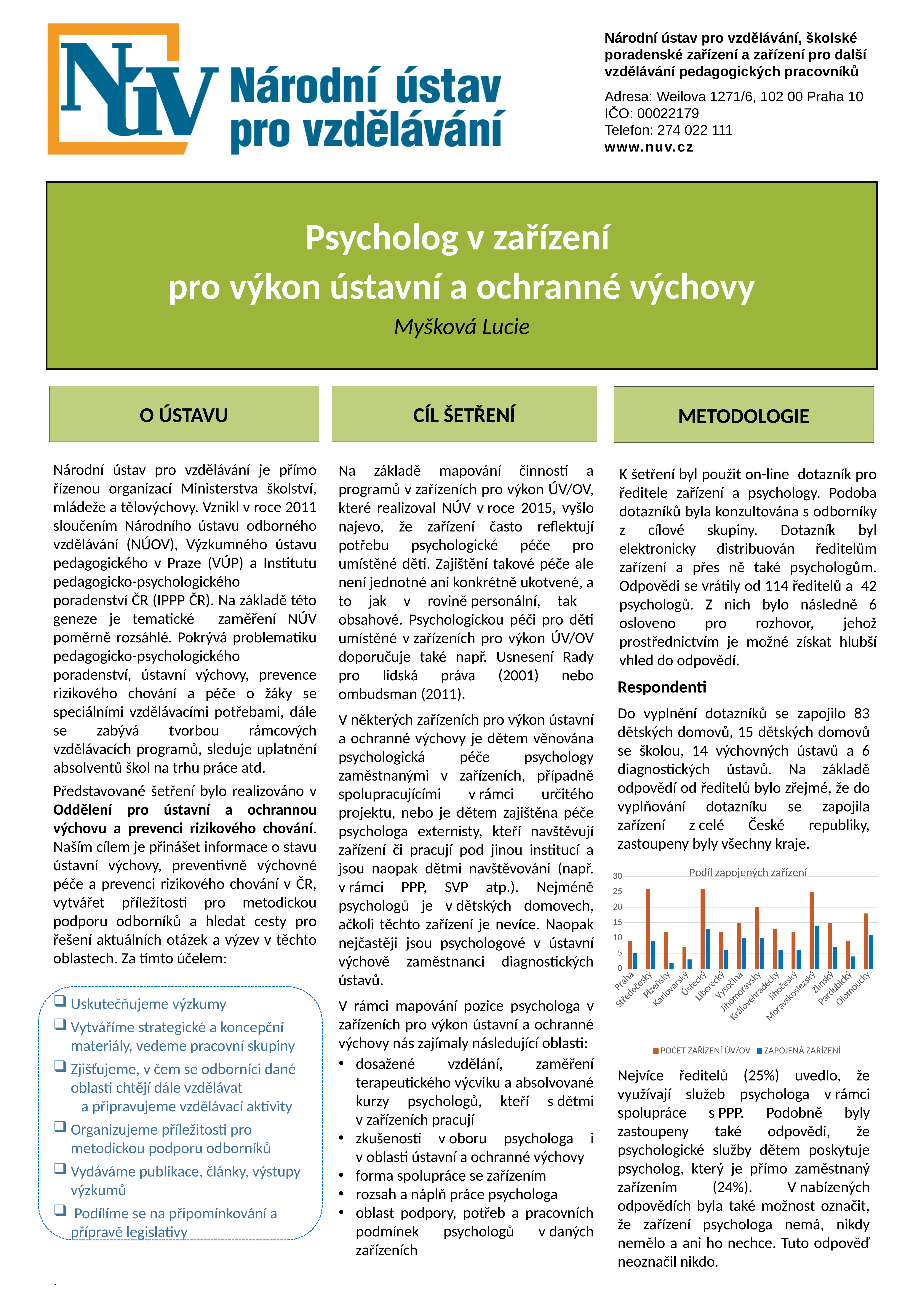
Is the value of POČET ZAŘÍZENÍ ÚV/OV for Středočeský greater or less than 20? greater What is the title of the chart on the slide? Podíl zapojených zařízení Is the value of POČET ZAŘÍZENÍ ÚV/OV for Karlovarský greater or less than 10? less Is the value of ZAPOJENÁ ZAŘÍZENÍ for Moravskoslezský greater or less than 10? greater Which series in the chart is shown in blue? ZAPOJENÁ ZAŘÍZENÍ Which has a larger value of ZAPOJENÁ ZAŘÍZENÍ, Ústecký or Plzeňský? Ústecký How many series does the legend of the chart list? 2 Which region has the lowest value of POČET ZAŘÍZENÍ ÚV/OV? Karlovarský Which has a larger value of POČET ZAŘÍZENÍ ÚV/OV, Ústecký or Praha? Ústecký What kind of chart is shown under the heading METODOLOGIE? bar chart How many regions (categories) are shown on the x axis of the chart? 14